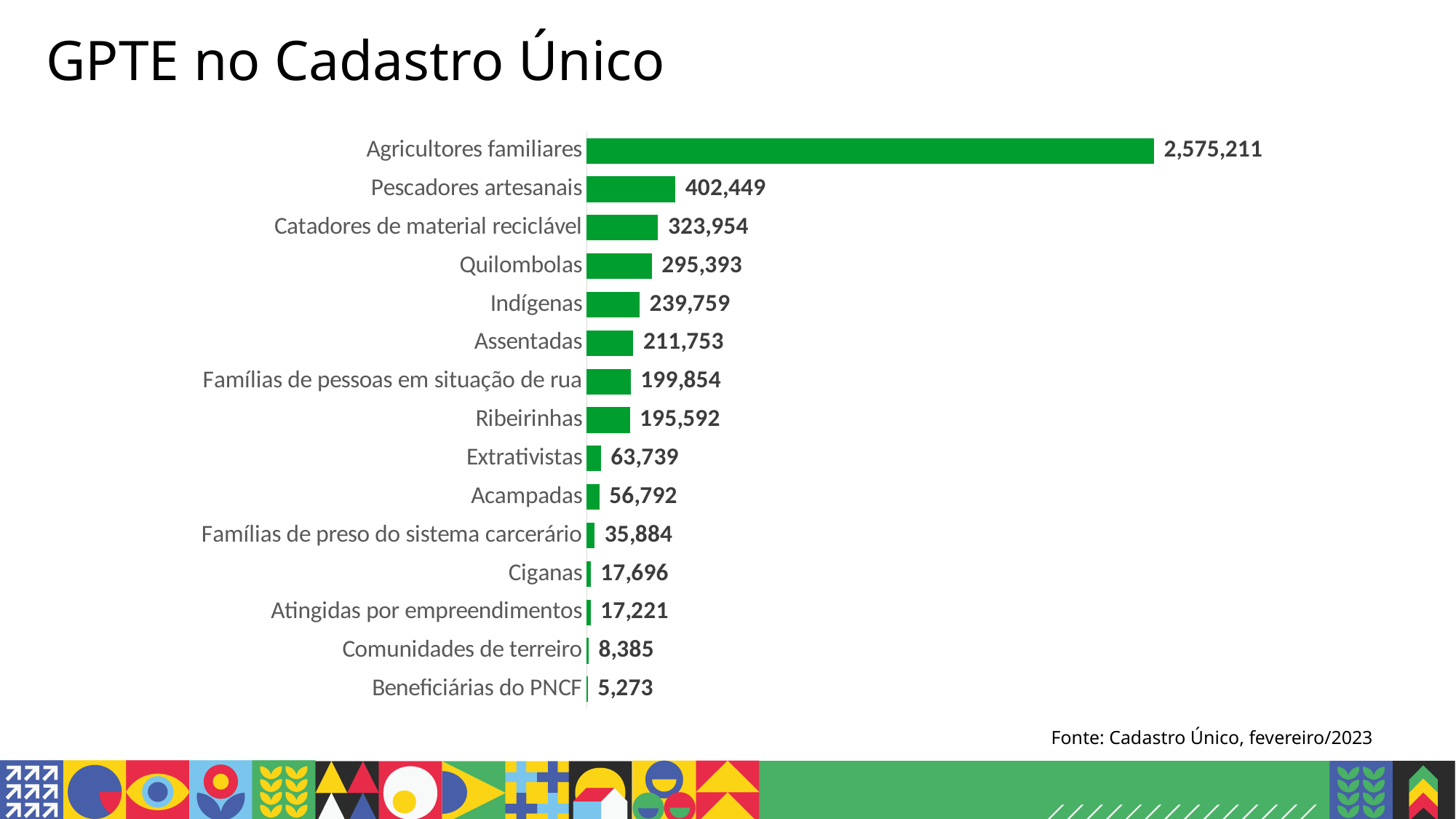
What is the value for Agricultores familiares? 2,575,211 What is the difference between the values for Pescadores artesanais and Catadores de material reciclável? 78,495 What is the value for Famílias de pessoas em situação de rua? 199,854 Which category has the highest value? Agricultores familiares Which category has the lowest value? Beneficiárias do PNCF What is the title of the slide? GPTE no Cadastro Único Which is larger, the value for Extrativistas or the value for Acampadas? Extrativistas What kind of chart is shown on the slide? Bar chart How many categories are shown in the chart? 15 What is the difference between the values for Quilombolas and Indígenas? 55,634 What is the value for Comunidades de terreiro? 8,385 What is the value for Quilombolas? 295,393